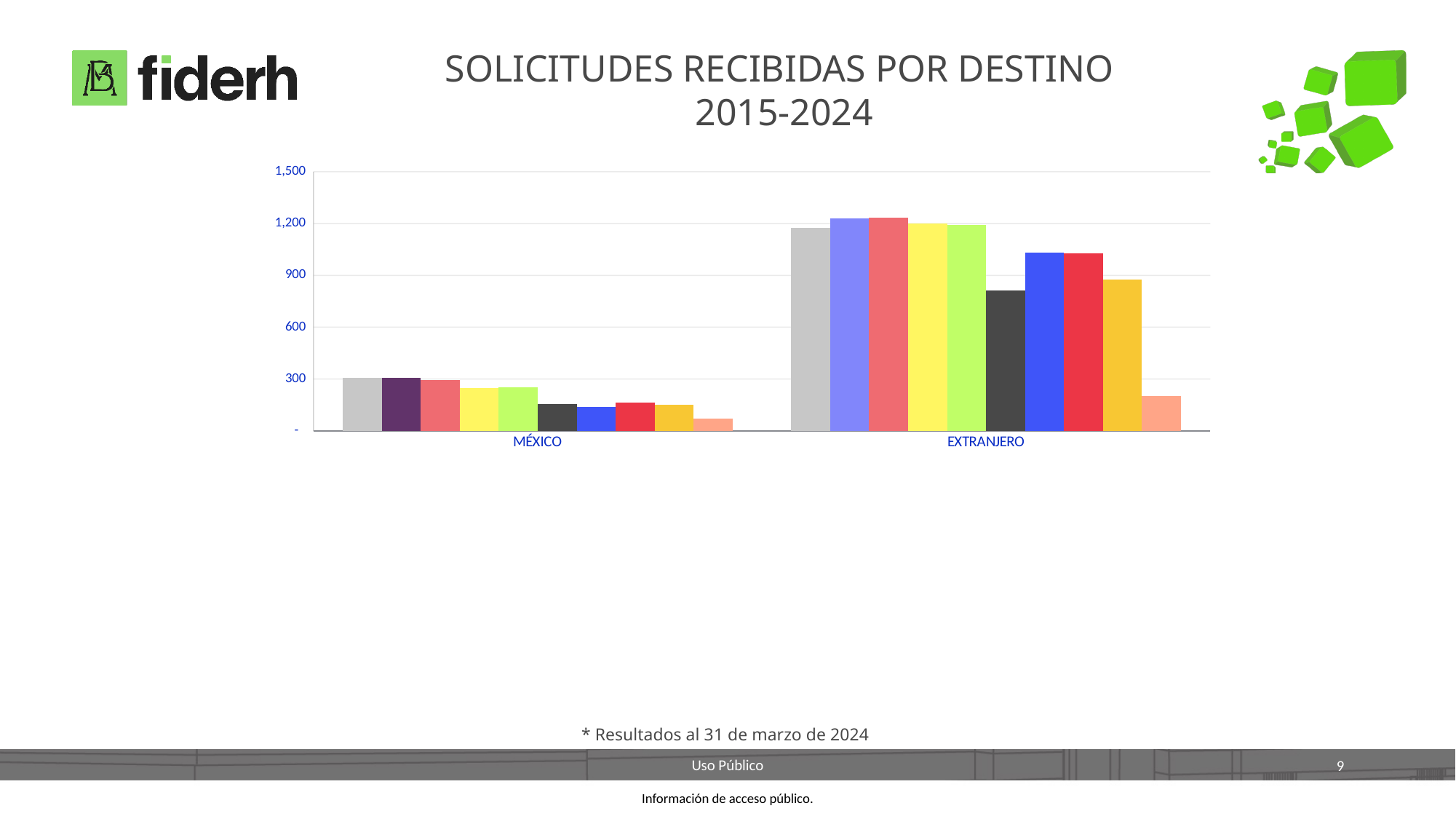
Is the first (grey) bar for EXTRANJERO greater or less than 900? greater What is the highest value shown on the vertical axis of the chart? 1,500 Is the tallest bar for EXTRANJERO greater or less than 900? greater Which category has the taller bars, MÉXICO or EXTRANJERO? EXTRANJERO What is the title of the chart on the slide? SOLICITUDES RECIBIDAS POR DESTINO 2015-2024 Is the tallest bar for MÉXICO greater or less than 600? less How many categories are shown on the x axis of the chart? 2 What kind of chart is shown on the slide? bar chart How many bars are plotted for the MÉXICO category? 10 How many bars are plotted for the EXTRANJERO category? 10